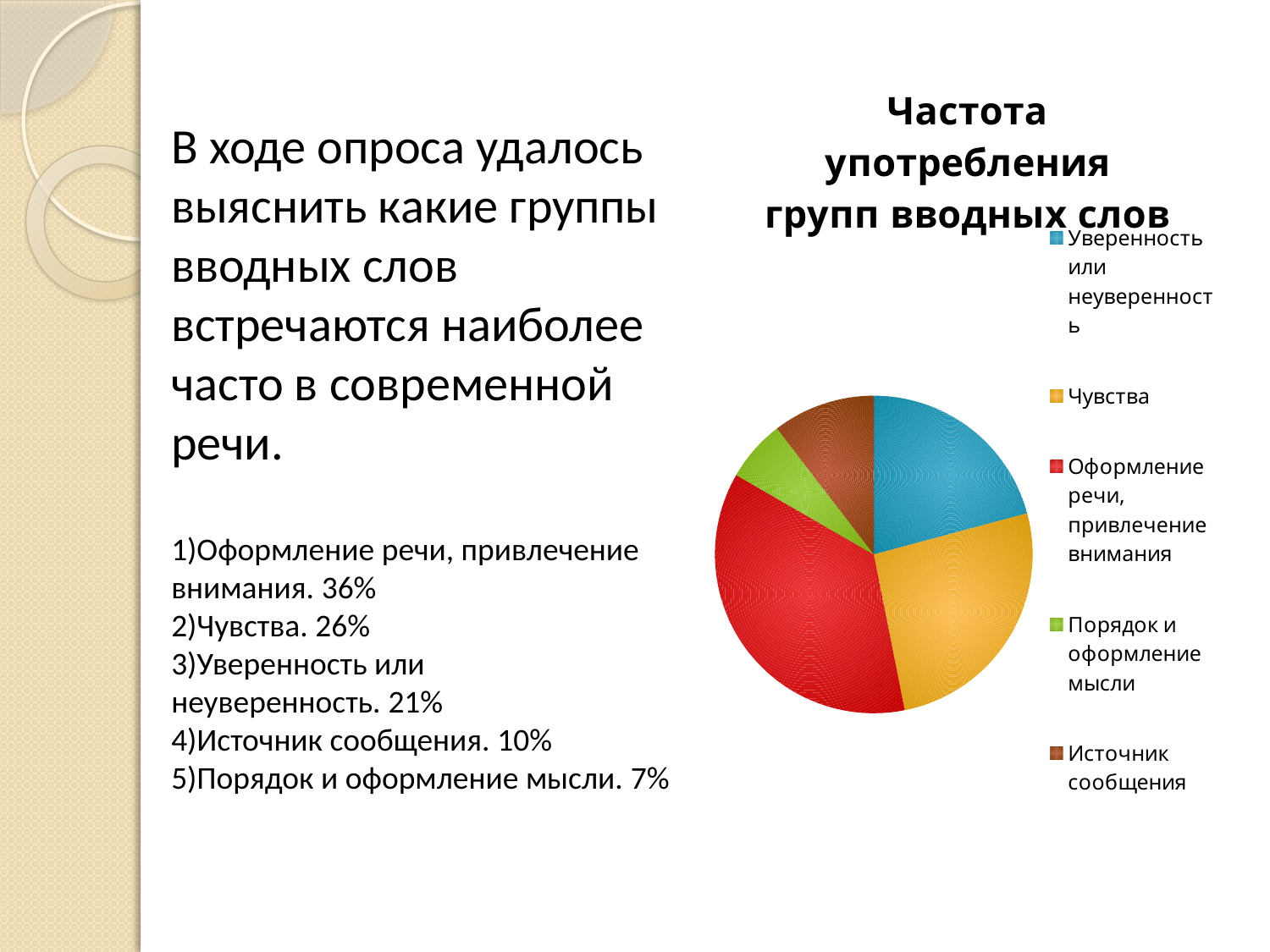
What is the title of the chart? Частота употребления групп вводных слов Which slice is larger: Оформление речи, привлечение внимания or Источник сообщения? Оформление речи, привлечение внимания What share of the pie does Источник сообщения take, according to the slide? 10% Which category has the largest slice of the pie? Оформление речи, привлечение внимания Which slice is larger: Чувства or Уверенность или неуверенность? Чувства What colour is the slice for Чувства? orange What share of the pie does Оформление речи, привлечение внимания take, according to the slide? 36% What share of the pie does Порядок и оформление мысли take, according to the slide? 7% How many categories does the pie chart show? 5 What kind of chart is shown on the slide? pie chart Which category has the smallest slice of the pie? Порядок и оформление мысли